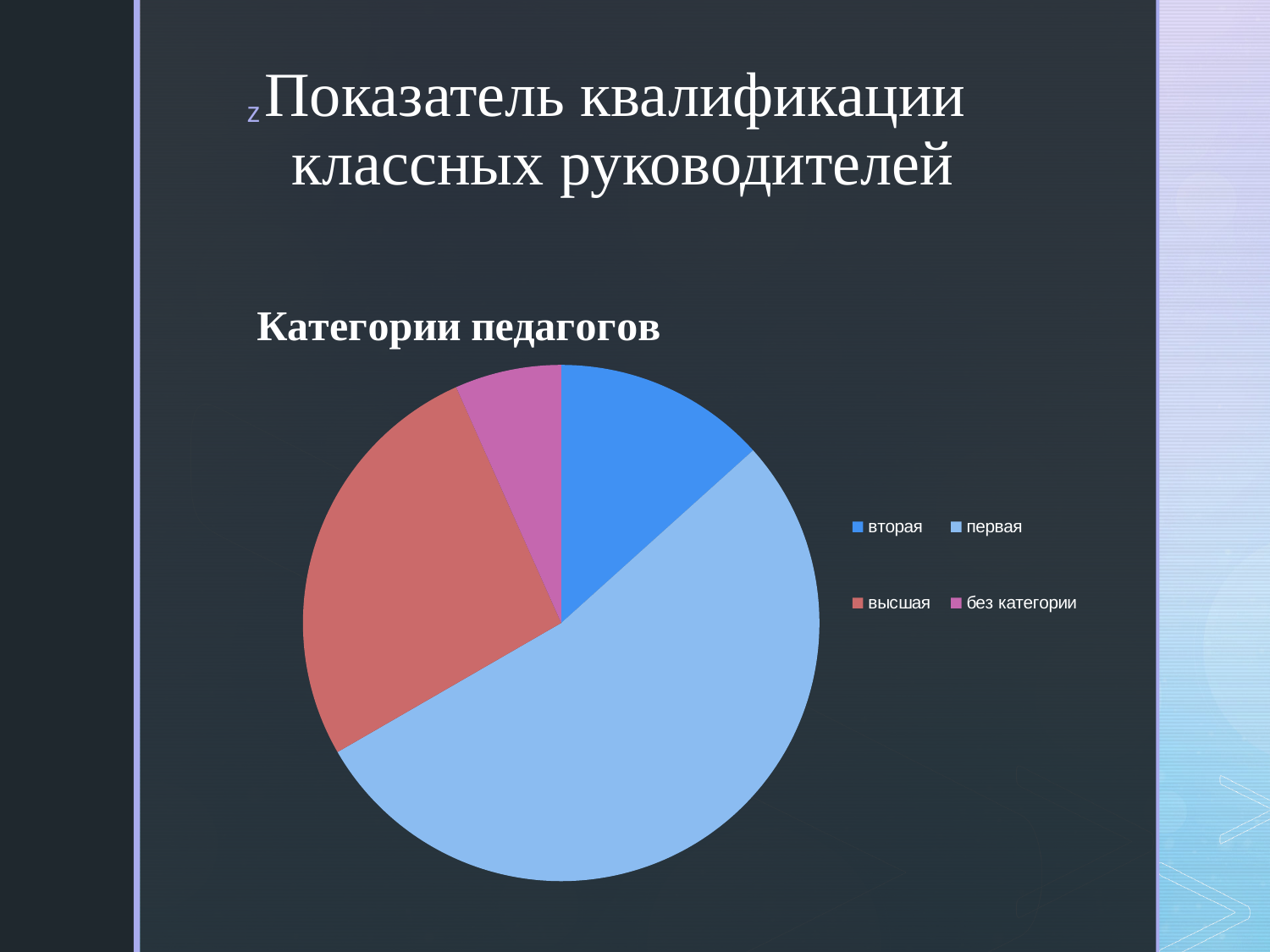
Does the slice for первая take up more or less than half of the pie? more How many entries does the legend list? 4 Which slice is larger: первая or высшая? первая Which category has the smallest slice of the pie? без категории What is the title of the chart? Категории педагогов What kind of chart is shown on the slide? pie chart How many categories (slices) does the pie chart have? 4 Which category has the largest slice of the pie? первая Which category is shown in the red slice? высшая Which slice is larger: высшая or вторая? высшая